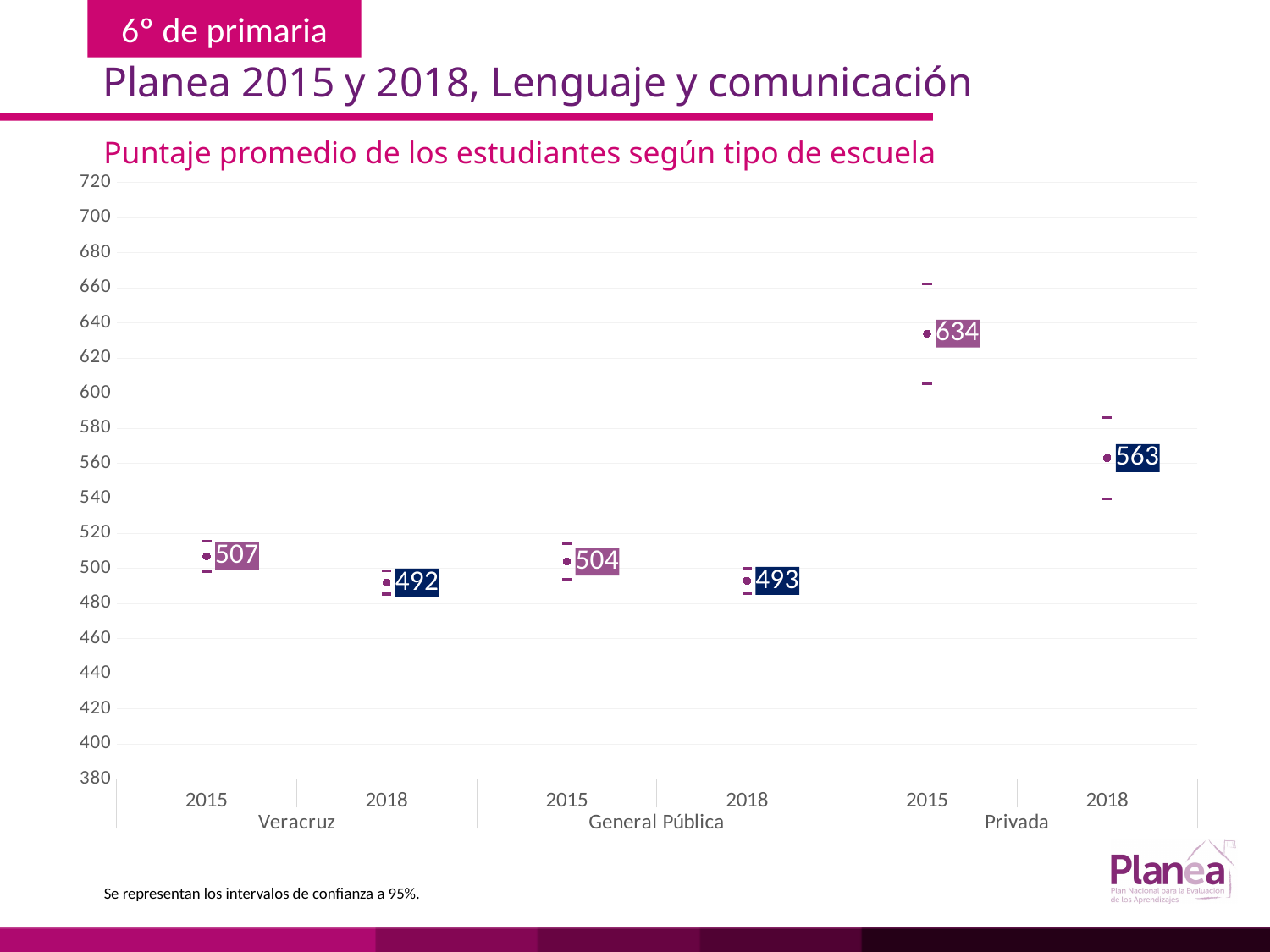
What is the title of the chart? Puntaje promedio de los estudiantes según tipo de escuela How many data points are plotted on the chart? 6 What is the difference between the Veracruz scores in 2015 and 2018? 15 Is the Privada 2015 score greater or less than 600? greater Did the Privada score rise or fall from 2015 to 2018? fall Which group and year has the lowest average score? Veracruz 2018 What is the average score for Veracruz in 2015? 507 Which group and year has the highest average score? Privada 2015 What is the difference between the Privada scores in 2015 and 2018? 71 What is the average score for General Pública in 2018? 493 Which is larger, the Veracruz 2015 score or the General Pública 2015 score? Veracruz 2015 What is the average score for Privada in 2018? 563